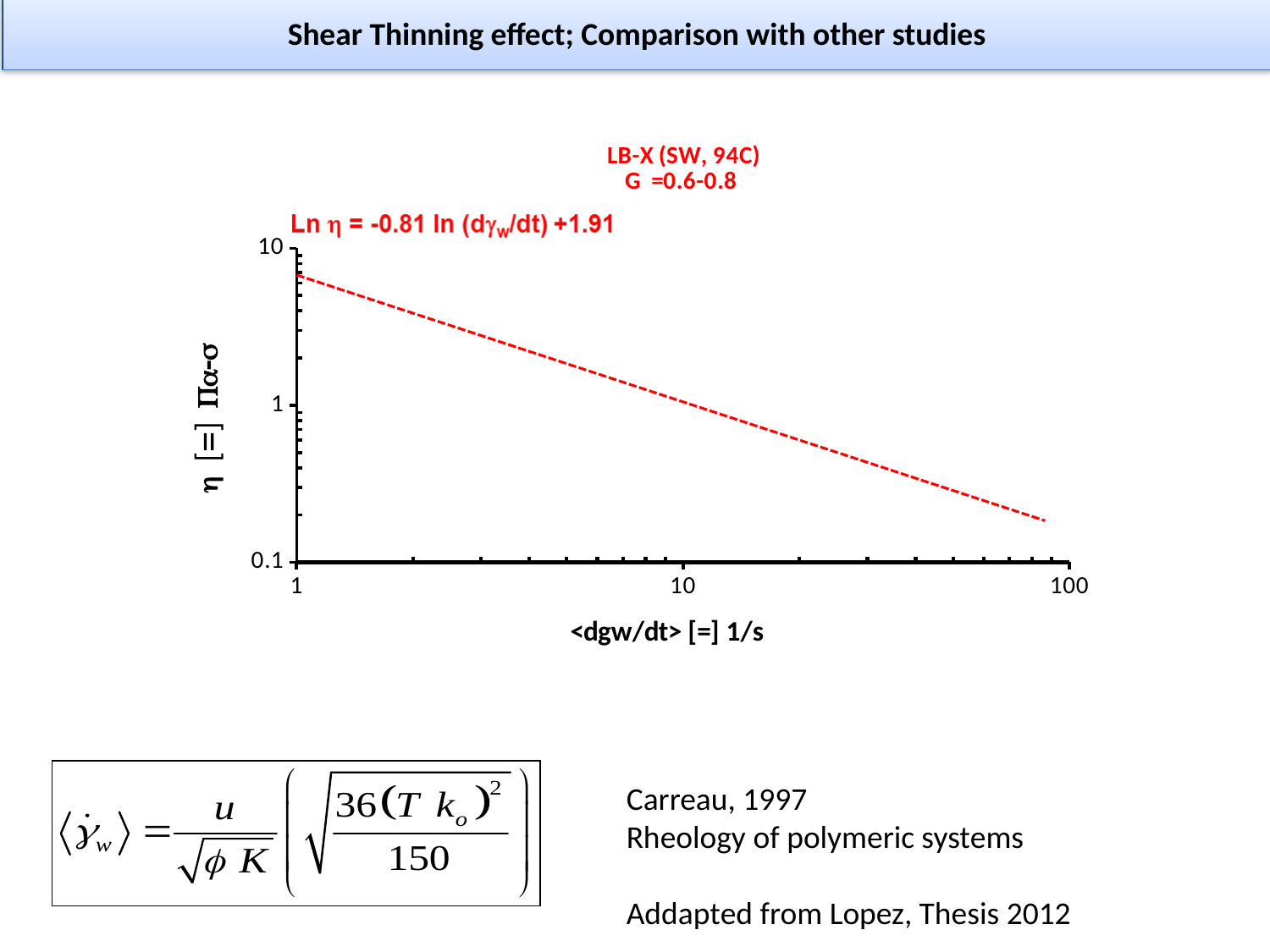
Is the value of η at the right-hand end of the dashed line (near 100 1/s) greater or less than 1? less Is the value of η at a shear rate of 1 1/s greater or less than 1? greater What is the slope coefficient in the fitted equation shown above the chart, Ln η = ? ln(dγw/dt) + 1.91? -0.81 What is the lowest tick value shown on the y axis? 0.1 Does the viscosity η rise or fall as the shear rate <dgw/dt> increases along the x axis? fall How many lines (series) are plotted on the chart? 1 What kind of chart is shown on the slide? line chart Is the value of η at a shear rate of 1 1/s greater or less than 10? less What is the highest tick value shown on the x axis? 100 What is the label of the x axis of the chart? <dgw/dt> [=] 1/s